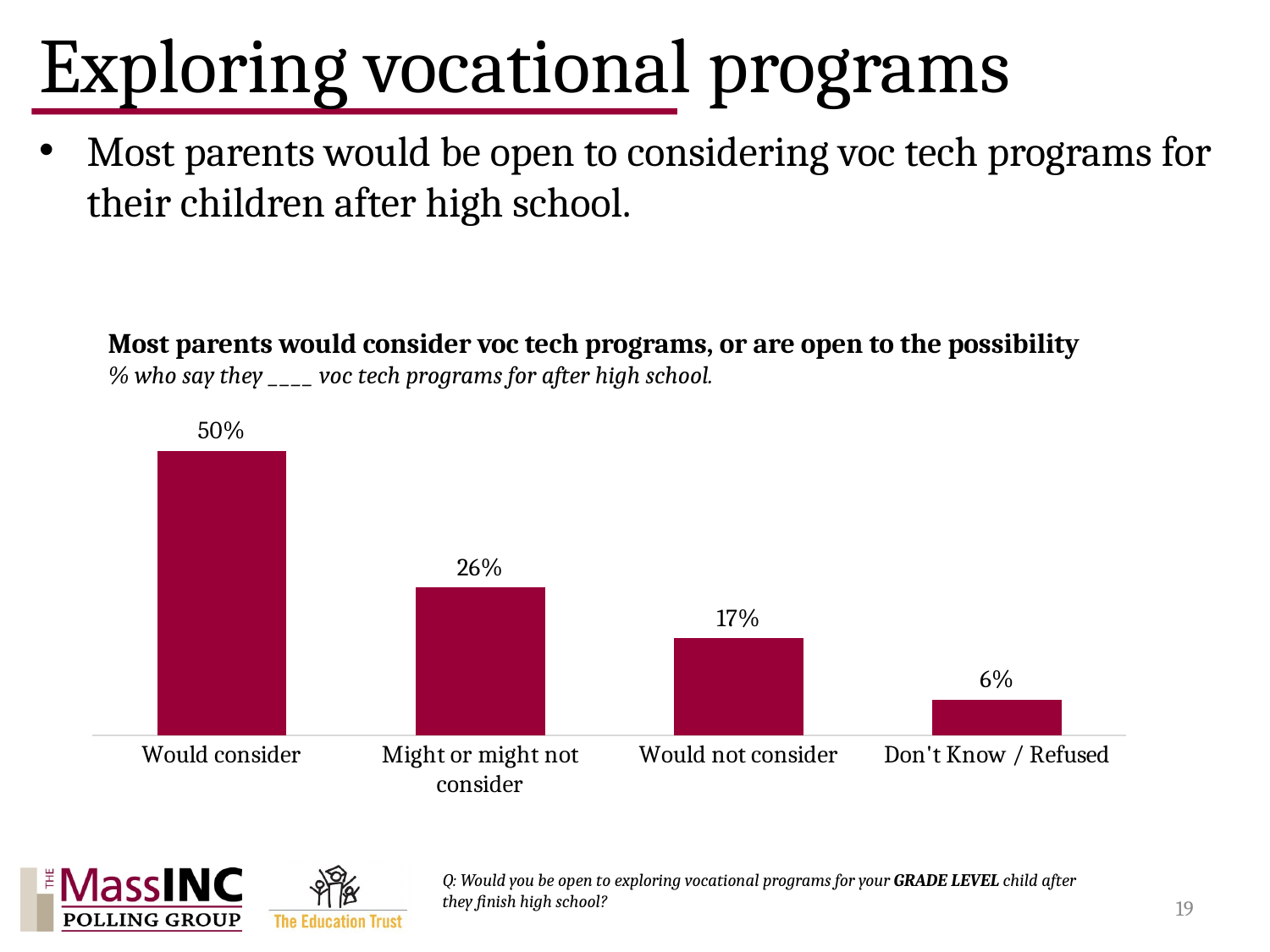
Which is larger: the percentage for 'Might or might not consider' or for 'Would not consider'? Might or might not consider What is the difference in percentage points between 'Might or might not consider' and 'Don't Know / Refused'? 20 What is the title of the chart? Most parents would consider voc tech programs, or are open to the possibility Which response category has the lowest percentage? Don't Know / Refused What percentage of parents say they would not consider voc tech programs? 17% What is the difference in percentage points between 'Would consider' and 'Would not consider'? 33 What percentage of parents answered Don't Know / Refused? 6% What percentage of parents say they would consider voc tech programs for after high school? 50% What percentage of parents say they might or might not consider voc tech programs? 26% How many response categories are shown in the chart? 4 Which response category has the highest percentage? Would consider What type of chart is shown on the slide? Bar chart